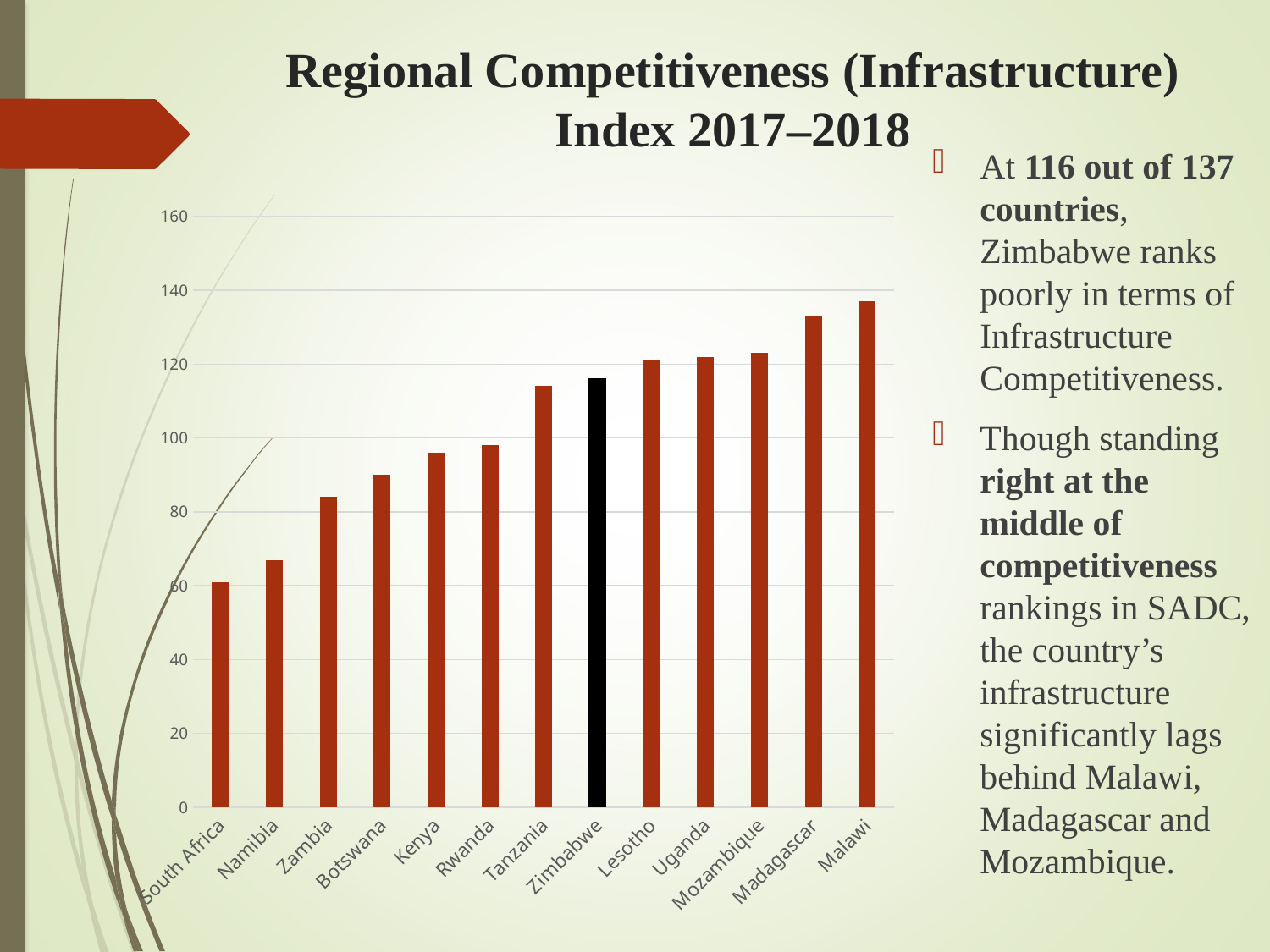
Which country has the highest bar in the chart? Malawi Is the value for Tanzania greater or less than 100? greater Which country's bar is coloured black instead of red? Zimbabwe Do the bar values rise or fall from left to right along the x axis? rise Which has the larger value, Kenya or Mozambique? Mozambique Which country has the lowest bar in the chart? South Africa Is the value for Namibia greater or less than 80? less What is the title of the chart on the slide? Regional Competitiveness (Infrastructure) Index 2017–2018 Is the value for Botswana greater or less than 100? less What kind of chart is shown on the slide? bar chart How many countries are shown on the x axis of the chart? 13